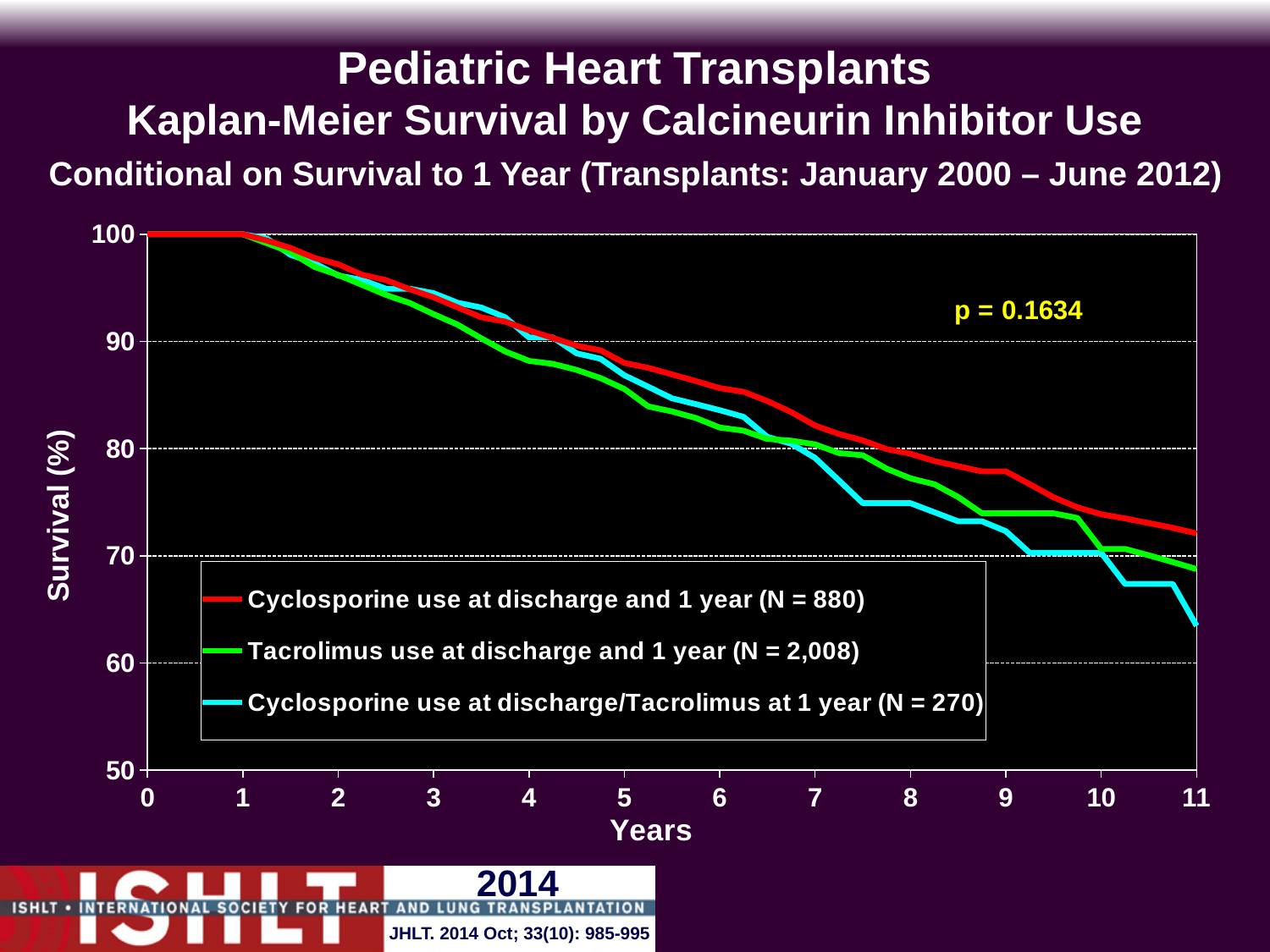
How many series does the legend list? 3 Which series has the lowest survival at 11 years? Cyclosporine use at discharge/Tacrolimus at 1 year What is the survival (%) for all three series at 0 years? 100 At 11 years, which series has higher survival: 'Cyclosporine use at discharge and 1 year' or 'Cyclosporine use at discharge/Tacrolimus at 1 year'? Cyclosporine use at discharge and 1 year Is the survival value for 'Cyclosporine use at discharge and 1 year' at 3 years greater or less than 90? greater Do the survival curves rise or fall as the years increase? fall Is the survival value for 'Cyclosporine use at discharge/Tacrolimus at 1 year' at 11 years greater or less than 70? less Is the survival value for 'Cyclosporine use at discharge/Tacrolimus at 1 year' at 8 years greater or less than 70? greater What kind of chart is shown on the slide? line chart What is the N for the 'Tacrolimus use at discharge and 1 year' series in the legend? 2,008 What is the p-value shown on the chart? p = 0.1634